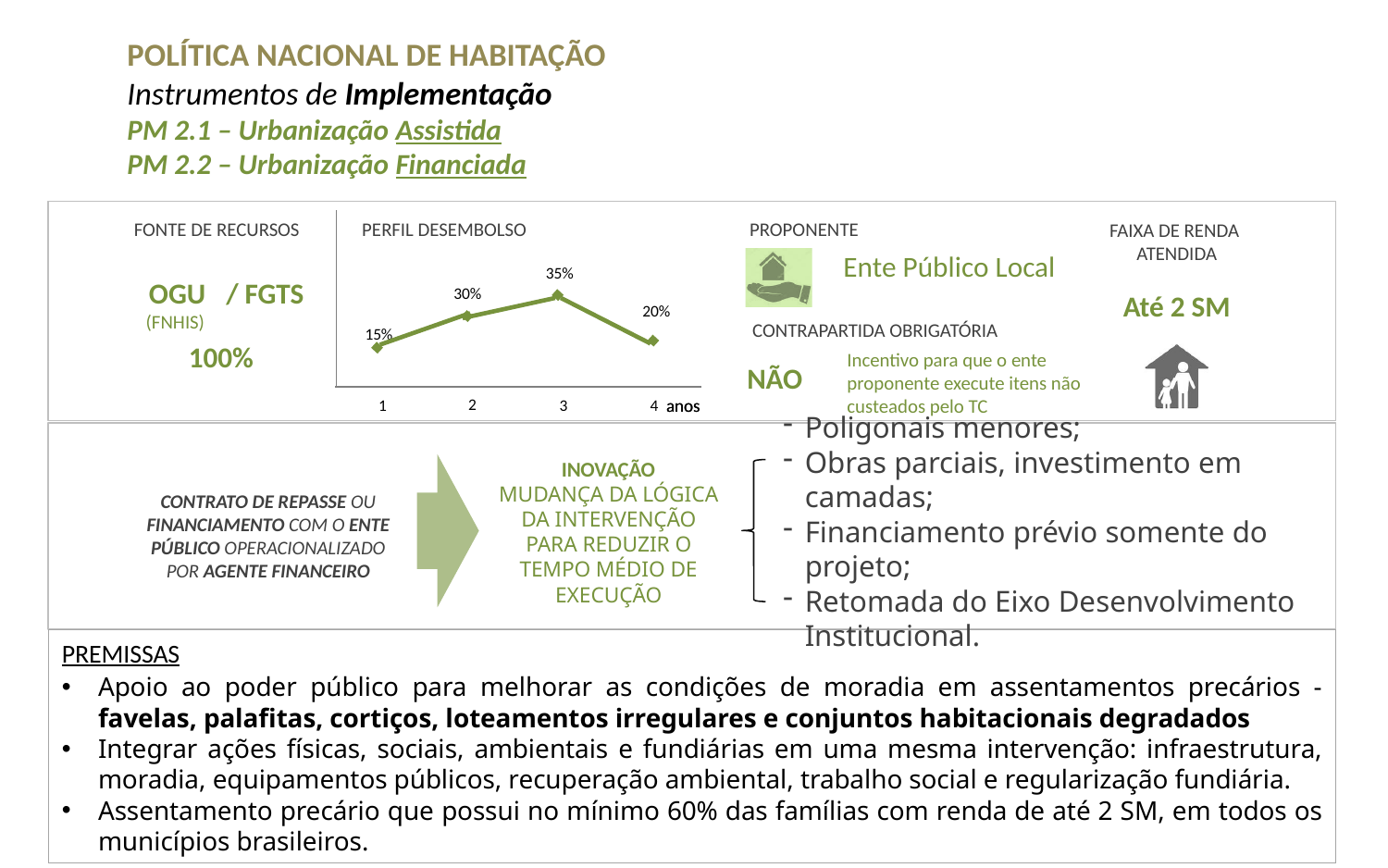
In the PERFIL DESEMBOLSO chart, what is the value for year 3? 35% What type of chart is shown under PERFIL DESEMBOLSO? line chart In the PERFIL DESEMBOLSO chart, what is the difference between the values for year 3 and year 1? 20% How many data points are plotted in the PERFIL DESEMBOLSO chart? 4 In the PERFIL DESEMBOLSO chart, what is the difference between the values for year 2 and year 4? 10% In the PERFIL DESEMBOLSO chart, which is larger, the value for year 2 or the value for year 4? year 2 In the PERFIL DESEMBOLSO chart, what is the value for year 4? 20% In the PERFIL DESEMBOLSO chart, which year has the lowest value? 1 In the PERFIL DESEMBOLSO chart, what is the value for year 1? 15% In the PERFIL DESEMBOLSO chart, which year has the highest value? 3 In the PERFIL DESEMBOLSO chart, do the values rise or fall from year 3 to year 4? fall In the PERFIL DESEMBOLSO chart, what is the value for year 2? 30%